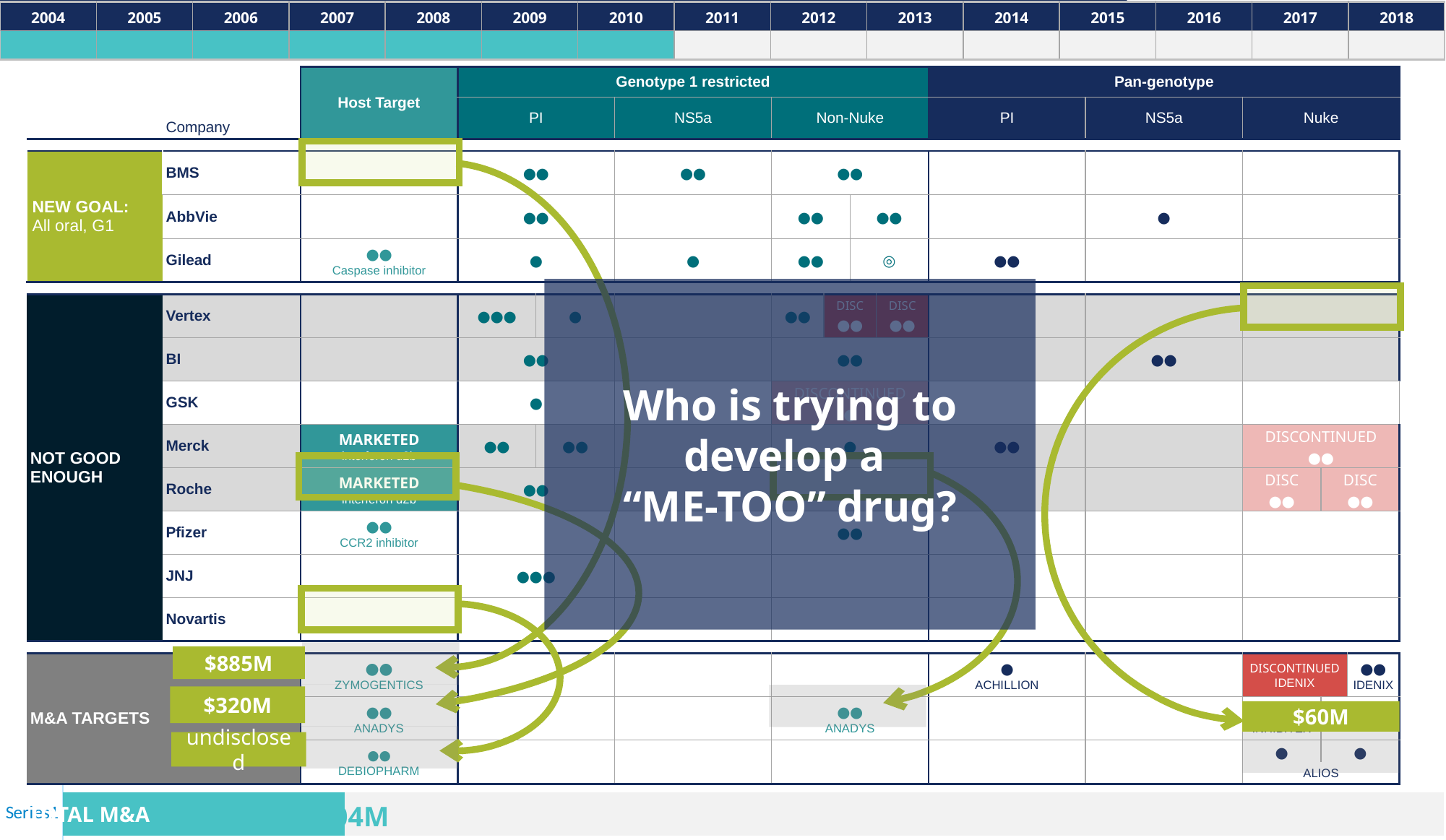
What is the last year shown on the timeline at the top of the slide? 2018 How many years are listed along the timeline at the top of the slide? 15 What is the difference between the Zymogenetics M&A value ($885M) and the Anadys M&A value ($320M)? $565M What is the first year shown on the timeline at the top of the slide? 2004 What M&A value is shown in the green box in the Pan-genotype Nuke column of the M&A Targets row? $60M What M&A value is shown for Anadys in the M&A Targets row? $320M Which of the disclosed M&A values shown on the slide is the highest? $885M What M&A value is shown for Zymogenetics in the M&A Targets row? $885M Which is larger, the M&A value for Zymogenetics or for Anadys? Zymogenetics What question is written in the large overlay box in the centre of the slide? Who is trying to develop a "ME-TOO" drug? What M&A value is shown for Debiopharm in the M&A Targets row? undisclosed Which of the disclosed M&A values shown on the slide is the lowest? $60M